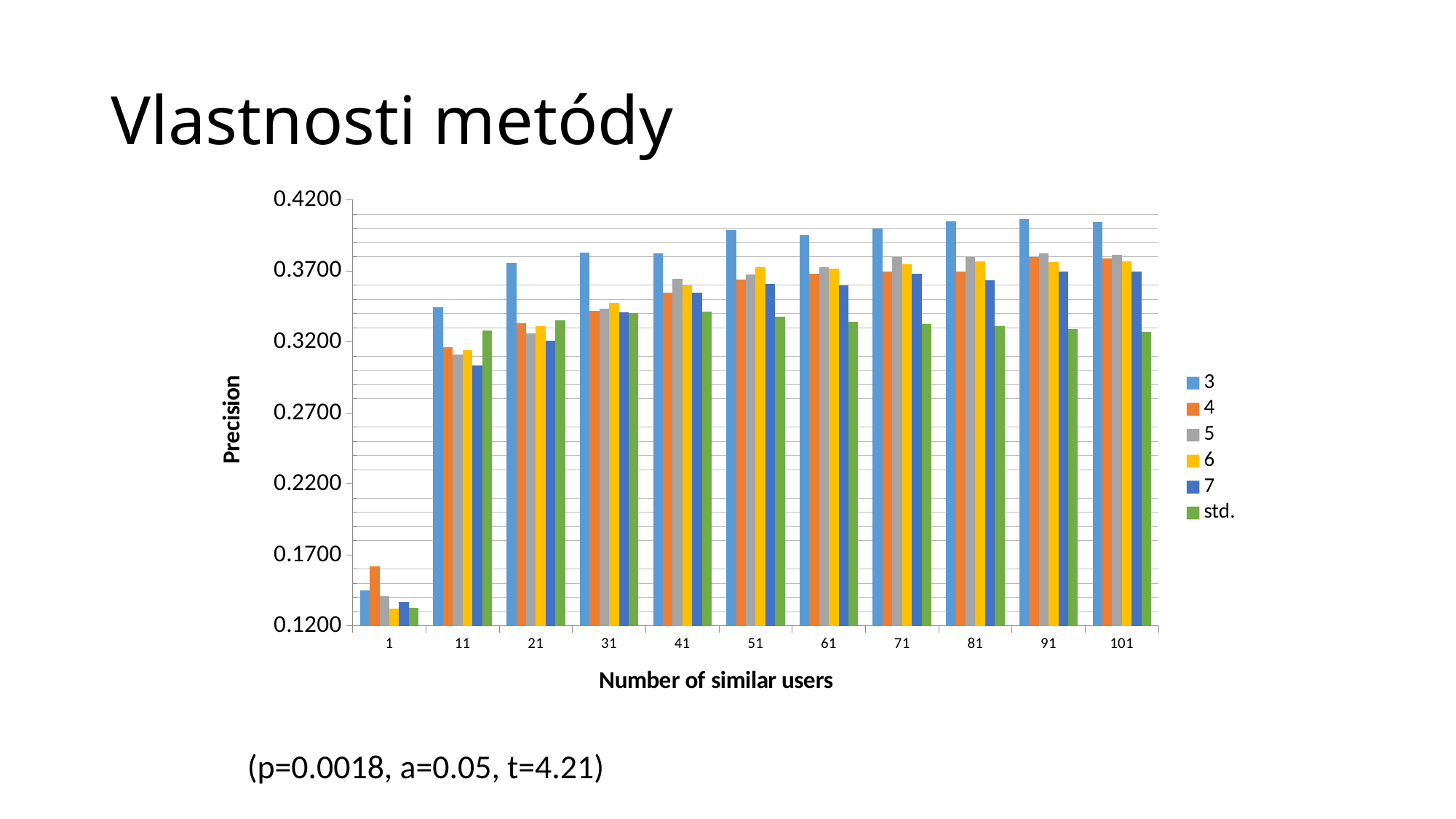
How many categories are shown on the x axis of the chart? 11 Is the value for series std. at 1 similar user greater or less than 0.1700? less Is the value for series 3 at 91 similar users greater or less than 0.3700? greater Is the value for series 7 at 11 similar users greater or less than 0.3200? less At 101 similar users, which series has the highest value? 3 At 1 similar user, which series has the larger value: 3 or 4? 4 How many series does the legend list? 6 What is the title of the y axis? Precision At 11 similar users, which series has the lowest value? 7 For series 3, which number of similar users has the lowest precision? 1 What kind of chart is shown on the slide? bar chart What is the title of the x axis? Number of similar users